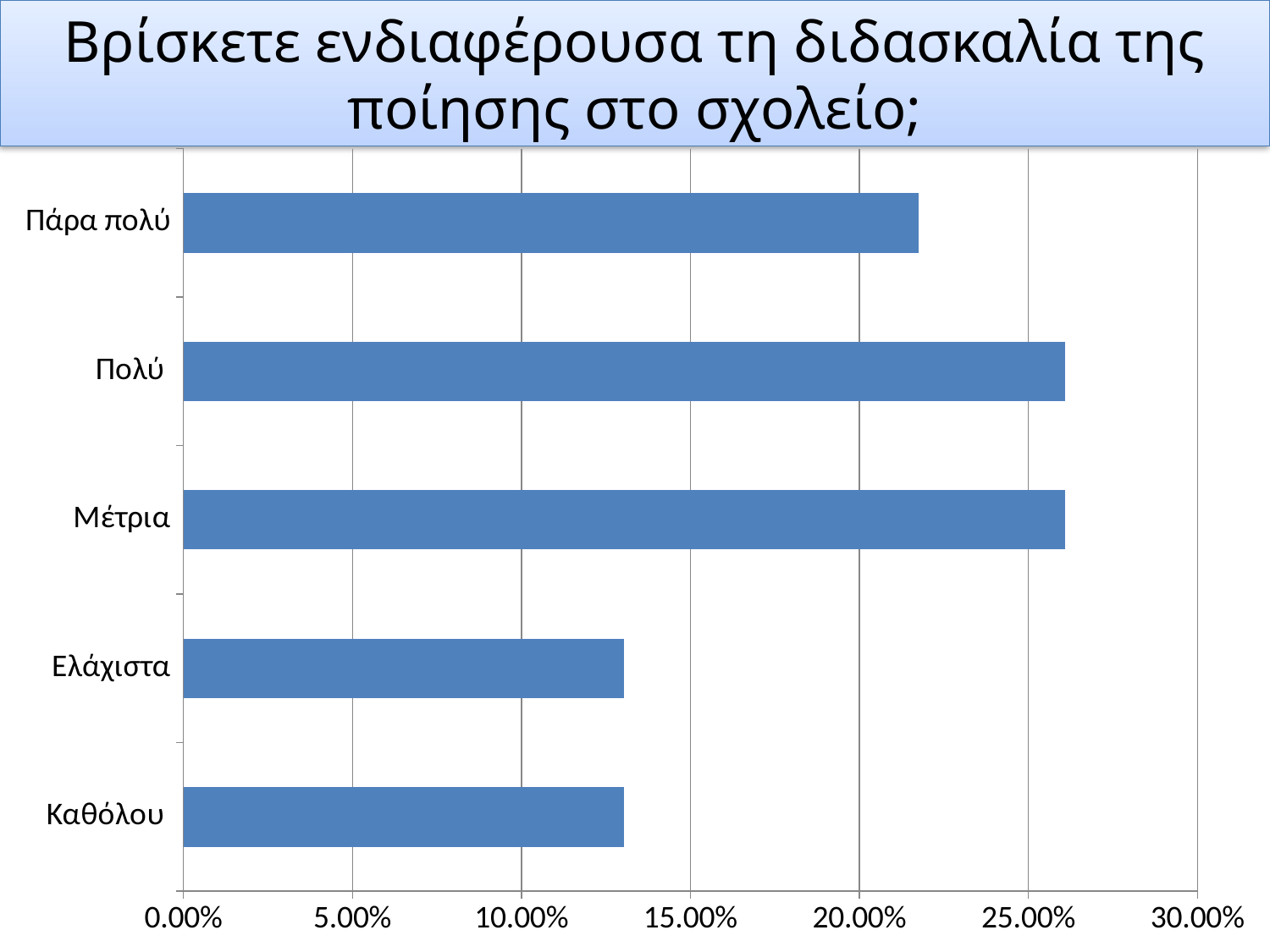
Which has the larger value, Πολύ or Πάρα πολύ? Πολύ Is the value for Καθόλου greater or less than 10.00%? greater What is the title of the chart on the slide? Βρίσκετε ενδιαφέρουσα τη διδασκαλία της ποίησης στο σχολείο; Is the value for Ελάχιστα greater or less than 15.00%? less How many categories are shown on the chart? 5 Is the value for Πάρα πολύ greater or less than 25.00%? less What kind of chart is shown on the slide? bar chart Which has the larger value, Μέτρια or Καθόλου? Μέτρια Which has the larger value, Πάρα πολύ or Ελάχιστα? Πάρα πολύ